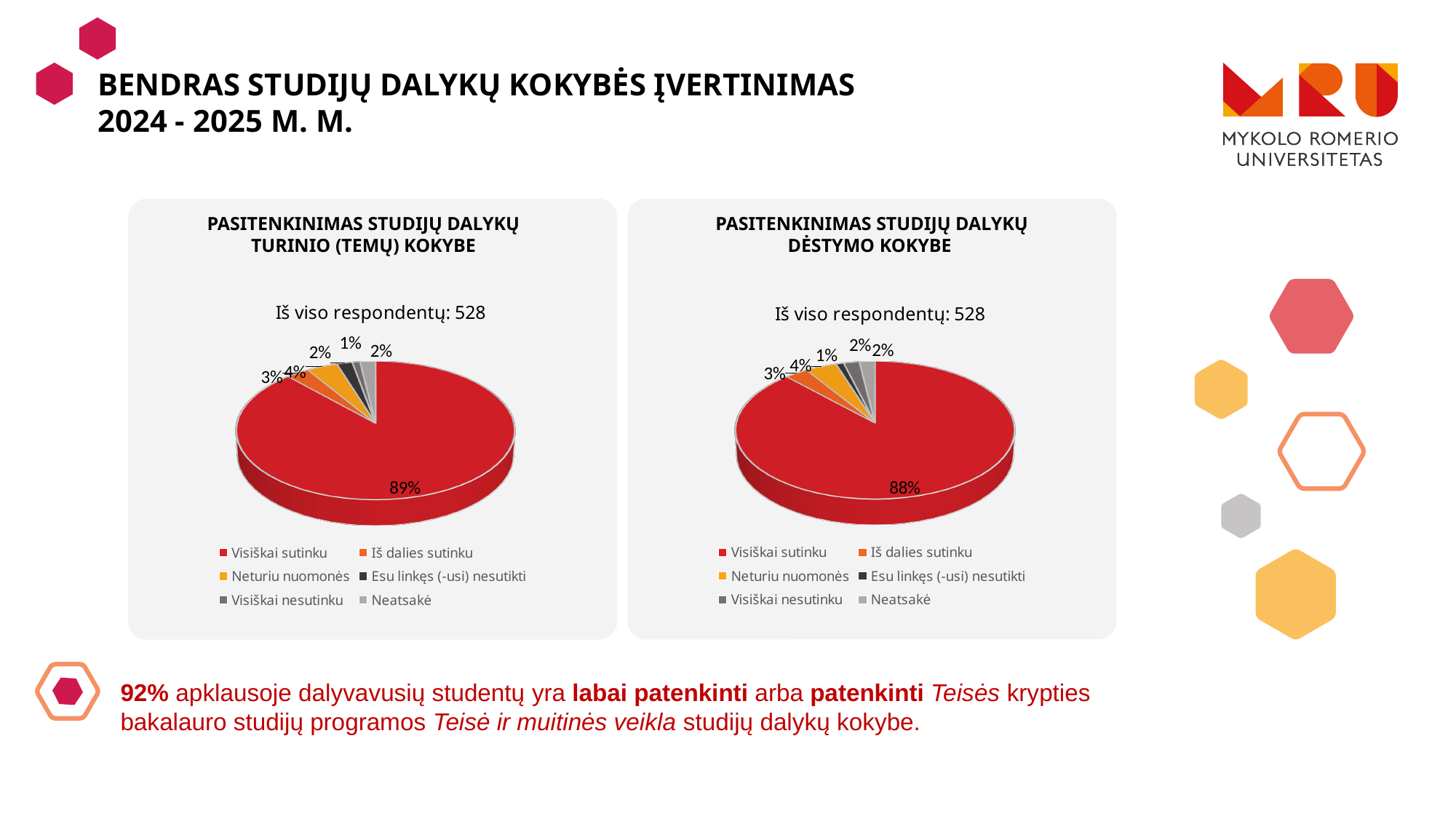
In the right chart (DĖSTYMO KOKYBE), what percentage is shown for "Iš dalies sutinku"? 3% In the left chart (TURINIO (TEMŲ) KOKYBE), which category has the largest slice? Visiškai sutinku In the right chart (DĖSTYMO KOKYBE), which category has the largest slice? Visiškai sutinku In the left chart (PASITENKINIMAS STUDIJŲ DALYKŲ TURINIO (TEMŲ) KOKYBE), what share of respondents answered "Visiškai sutinku"? 89% What type of chart is used in the left panel (TURINIO (TEMŲ) KOKYBE)? Pie chart In the left chart (TURINIO (TEMŲ) KOKYBE), what colour is the "Visiškai sutinku" slice? Red Which chart shows a larger share for "Visiškai sutinku": the left chart (TURINIO (TEMŲ) KOKYBE) or the right chart (DĖSTYMO KOKYBE)? The left chart (TURINIO (TEMŲ) KOKYBE) How many categories does the legend of the right chart (DĖSTYMO KOKYBE) list? 6 What is the difference between the "Visiškai sutinku" share in the left chart (89%) and in the right chart (88%)? 1% How many respondents in total are reported for the left chart (TURINIO (TEMŲ) KOKYBE)? 528 In the right chart (PASITENKINIMAS STUDIJŲ DALYKŲ DĖSTYMO KOKYBE), what share of respondents answered "Visiškai sutinku"? 88% In the left chart (TURINIO (TEMŲ) KOKYBE), what percentage is shown for "Neturiu nuomonės"? 4%